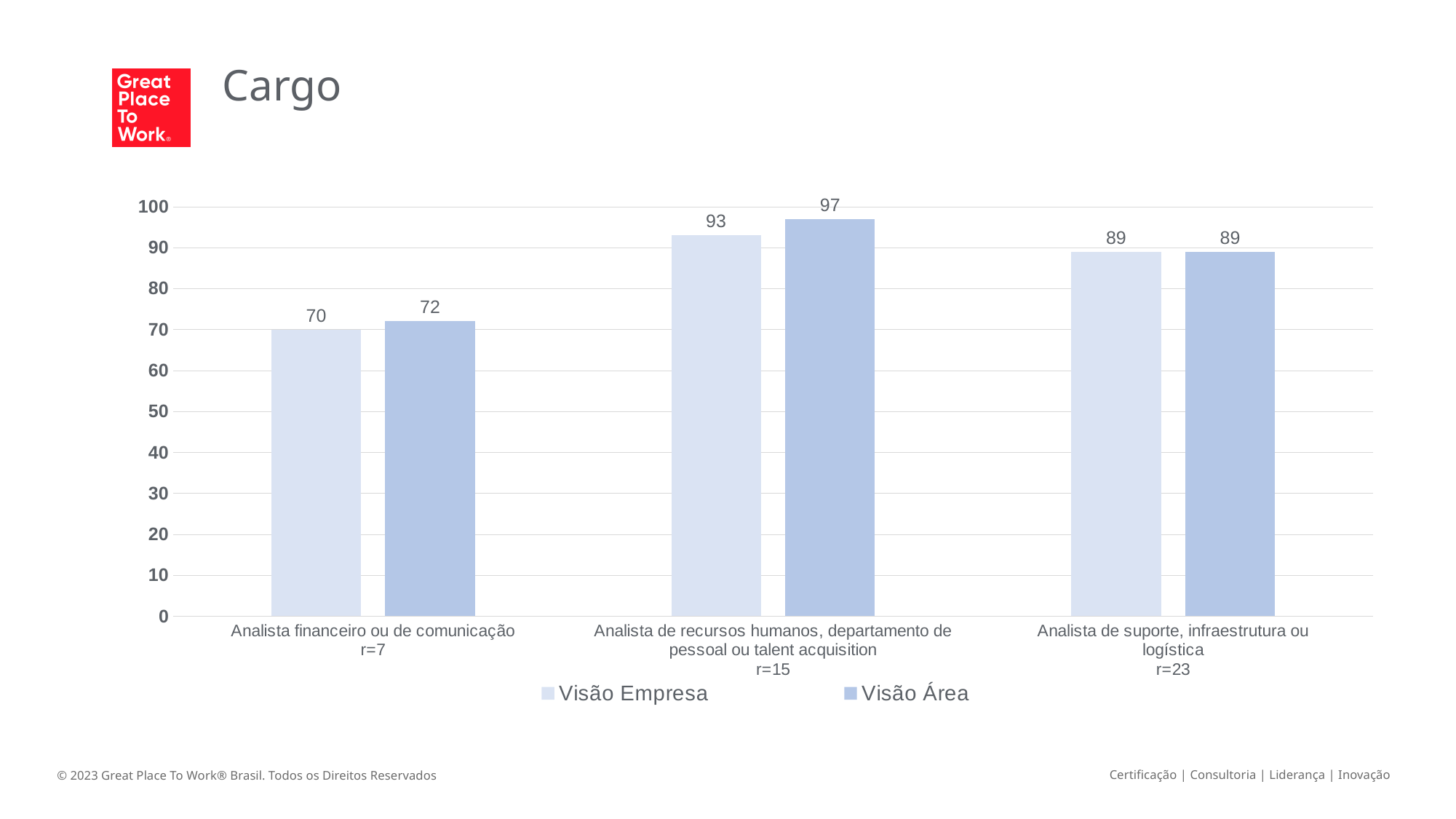
How many categories are shown on the x axis? 3 Which is larger for Analista financeiro ou de comunicação: Visão Empresa or Visão Área? Visão Área What is the Visão Empresa value for Analista financeiro ou de comunicação? 70 Which category has the lowest Visão Empresa value? Analista financeiro ou de comunicação What is the difference between the Visão Área and Visão Empresa values for Analista de recursos humanos, departamento de pessoal ou talent acquisition? 4 What is the Visão Área value for Analista de recursos humanos, departamento de pessoal ou talent acquisition? 97 Is the Visão Empresa value for Analista de recursos humanos, departamento de pessoal ou talent acquisition greater or less than 90? greater How many series does the legend list? 2 What kind of chart is shown on the slide? bar chart What is the Visão Empresa value for Analista de suporte, infraestrutura ou logística? 89 Which category has the highest Visão Área value? Analista de recursos humanos, departamento de pessoal ou talent acquisition What is the title of the slide? Cargo